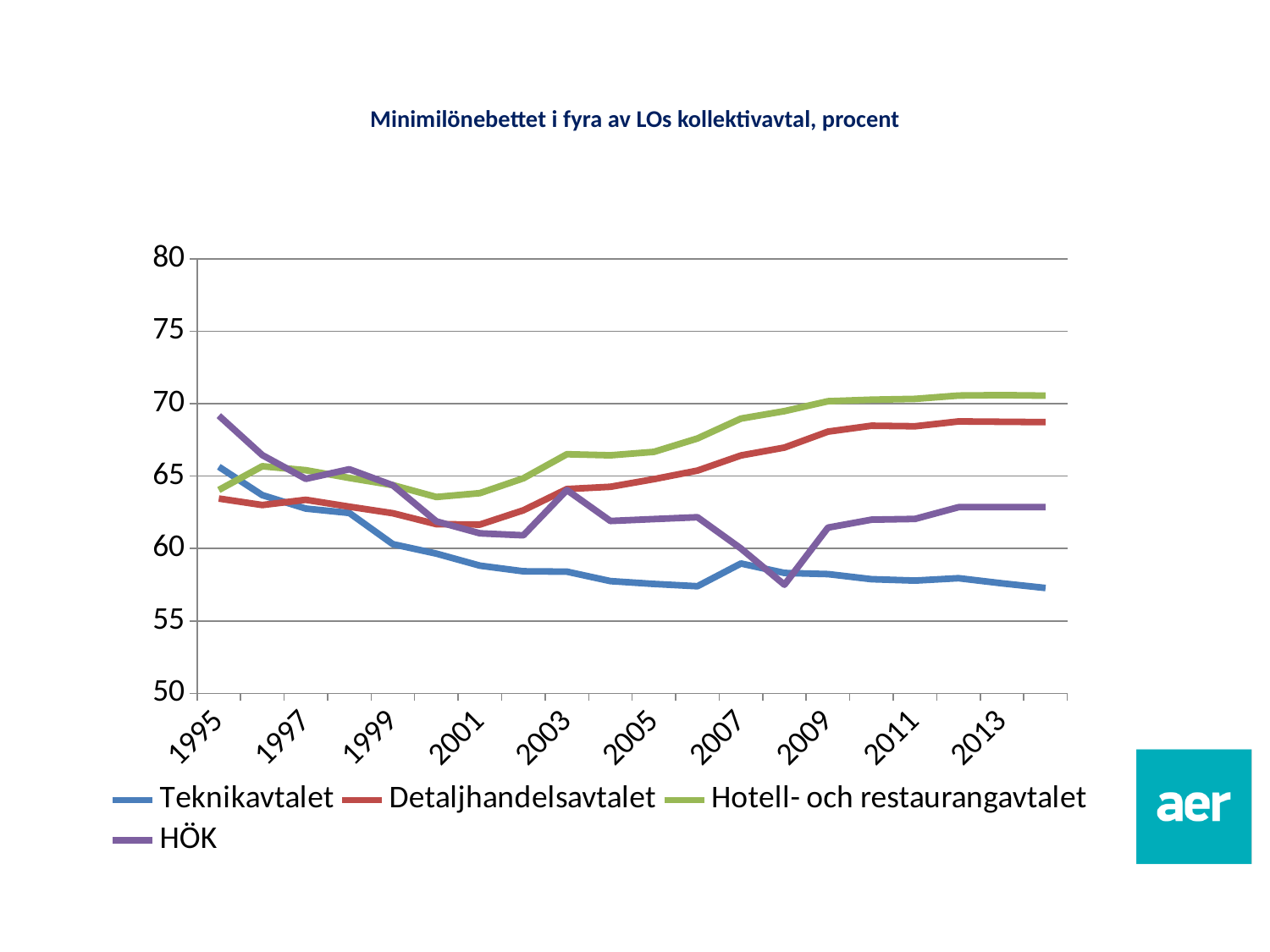
Is the value for Hotell- och restaurangavtalet in 2013 greater or less than 70? greater Is the value for Teknikavtalet in 2013 greater or less than 60? less Is the value for Detaljhandelsavtalet in 2001 greater or less than 65? less What kind of chart is shown on the slide? line chart What is the title of the chart? Minimilönebettet i fyra av LOs kollektivavtal, procent How many series does the legend list? 4 Which series is drawn in green? Hotell- och restaurangavtalet Which series has the lowest value in 2013? Teknikavtalet In 2009, which is larger: Detaljhandelsavtalet or HÖK? Detaljhandelsavtalet Does the Teknikavtalet line rise or fall from 1995 to 2013? fall Which series has the highest value in 2013? Hotell- och restaurangavtalet